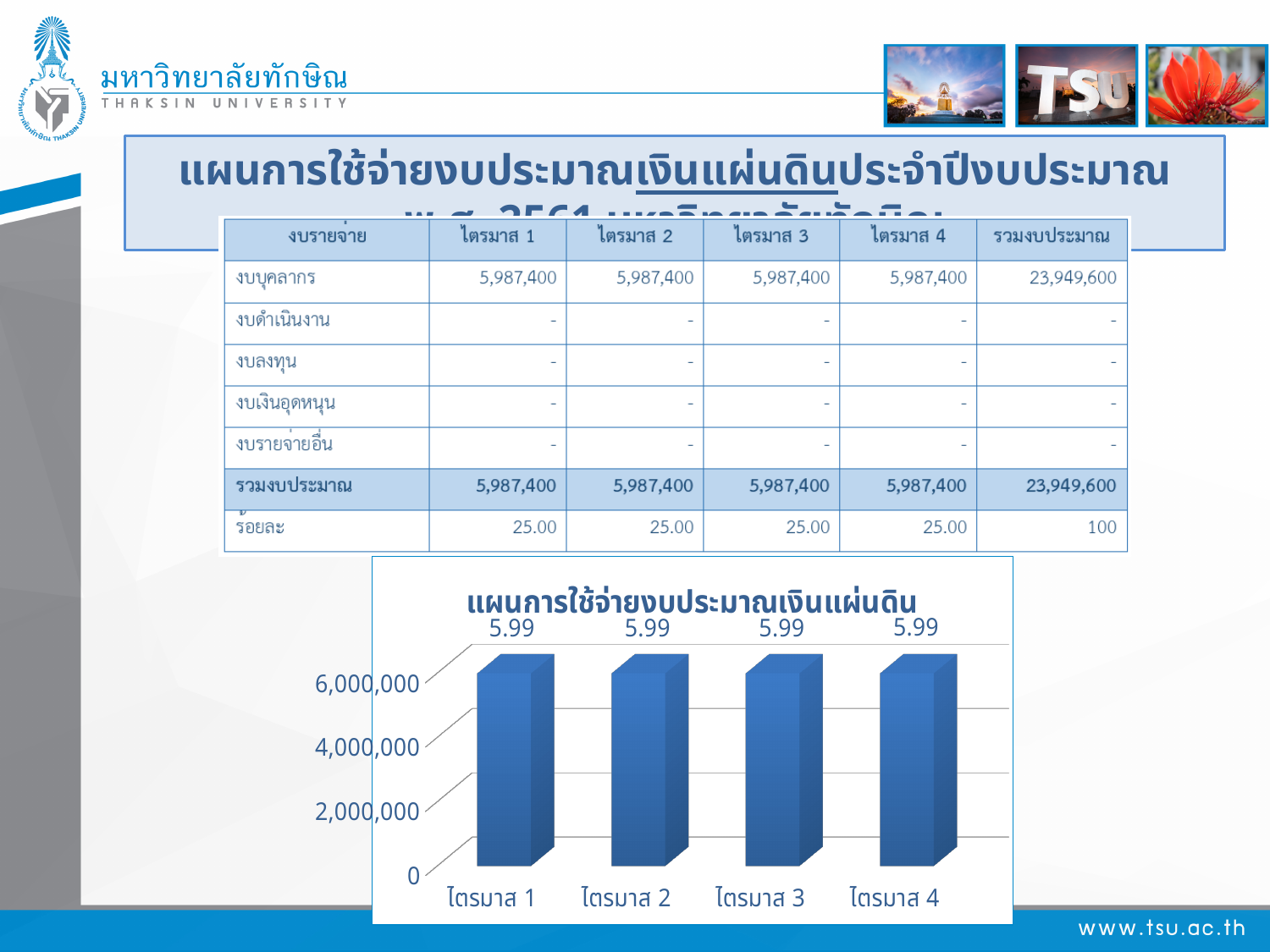
Is the value for ไตรมาส 4 greater or less than 2,000,000? greater What is the data label shown above the bar for ไตรมาส 1? 5.99 What is the data label shown above the bar for ไตรมาส 4? 5.99 Do the bar values rise, fall, or stay the same from ไตรมาส 1 to ไตรมาส 4? stay the same What kind of chart is shown on the slide? bar chart What is the difference between the data labels for ไตรมาส 1 and ไตรมาส 2? 0 What is the data label shown above the bar for ไตรมาส 3? 5.99 What is the title of the chart? แผนการใช้จ่ายงบประมาณเงินแผ่นดิน What is the highest tick value shown on the y axis of the chart? 6,000,000 How many categories are plotted on the x axis of the chart? 4 Is the value for ไตรมาส 2 greater or less than 4,000,000? greater